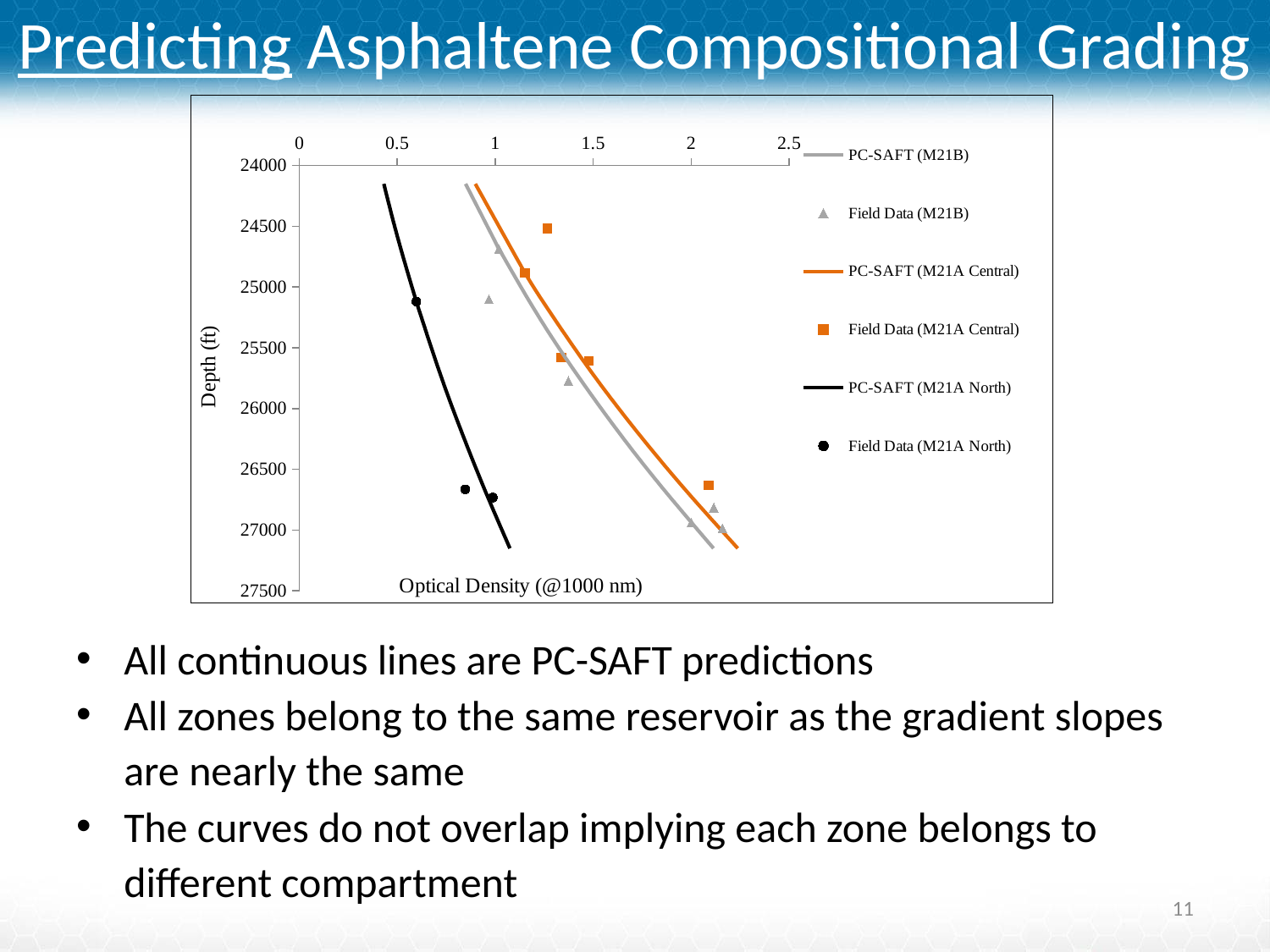
Which PC-SAFT line lies furthest to the left (lowest optical density) on the chart? PC-SAFT (M21A North) How many Field Data (M21A North) points are plotted? 3 Is the optical density of the shallowest Field Data (M21A North) point greater or less than 1? less Which PC-SAFT line lies furthest to the right (highest optical density) on the chart? PC-SAFT (M21A Central) What is the title of the vertical axis? Depth (ft) Is the optical density of the deepest Field Data (M21A Central) point greater or less than 2? greater What kind of chart is shown on the slide? Scatter chart with lines Does optical density increase or decrease as depth increases along the PC-SAFT (M21B) line? increase What is the title of the horizontal axis? Optical Density (@1000 nm) How many Field Data (M21A Central) points are plotted? 5 How many series does the legend list? 6 What is the largest value shown on the optical density axis? 2.5